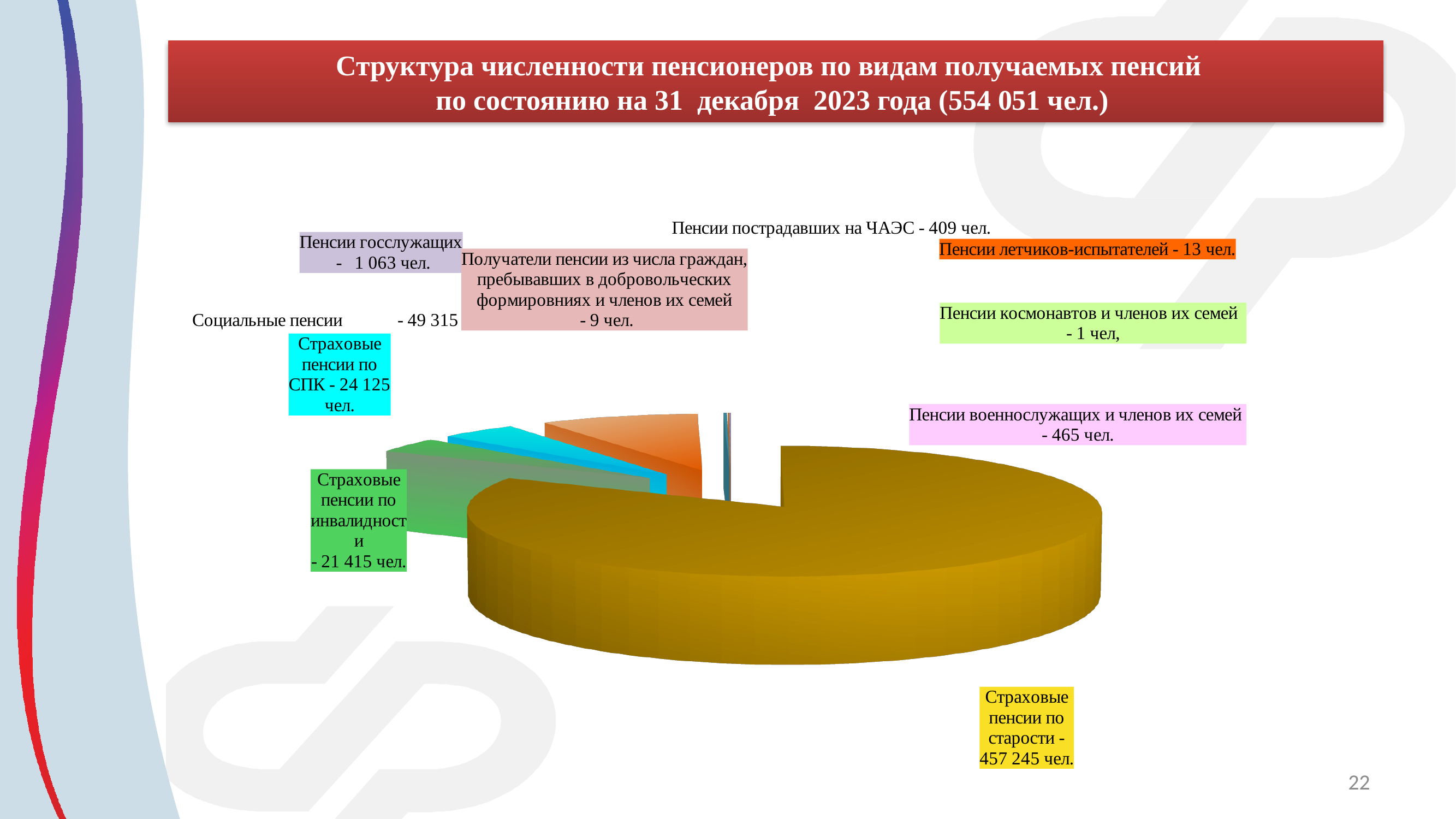
What type of chart is shown on the slide? Pie chart What is the value for Страховые пенсии по СПК? 24 125 чел. How many people receive Социальные пенсии? 49 315 What is the value for Пенсии космонавтов и членов их семей? 1 чел. What is the number of recipients of Страховые пенсии по старости? 457 245 чел. Which category has the largest number of pensioners? Страховые пенсии по старости How many pension categories are shown on the chart? 10 What is the difference between Социальные пенсии and Страховые пенсии по СПК? 25 190 What is the difference between Пенсии военнослужащих и членов их семей and Пенсии пострадавших на ЧАЭС? 56 How many people receive Пенсии пострадавших на ЧАЭС? 409 чел. Which category has the smallest number of pensioners? Пенсии космонавтов и членов их семей Which is larger: Страховые пенсии по инвалидности or Страховые пенсии по СПК? Страховые пенсии по СПК